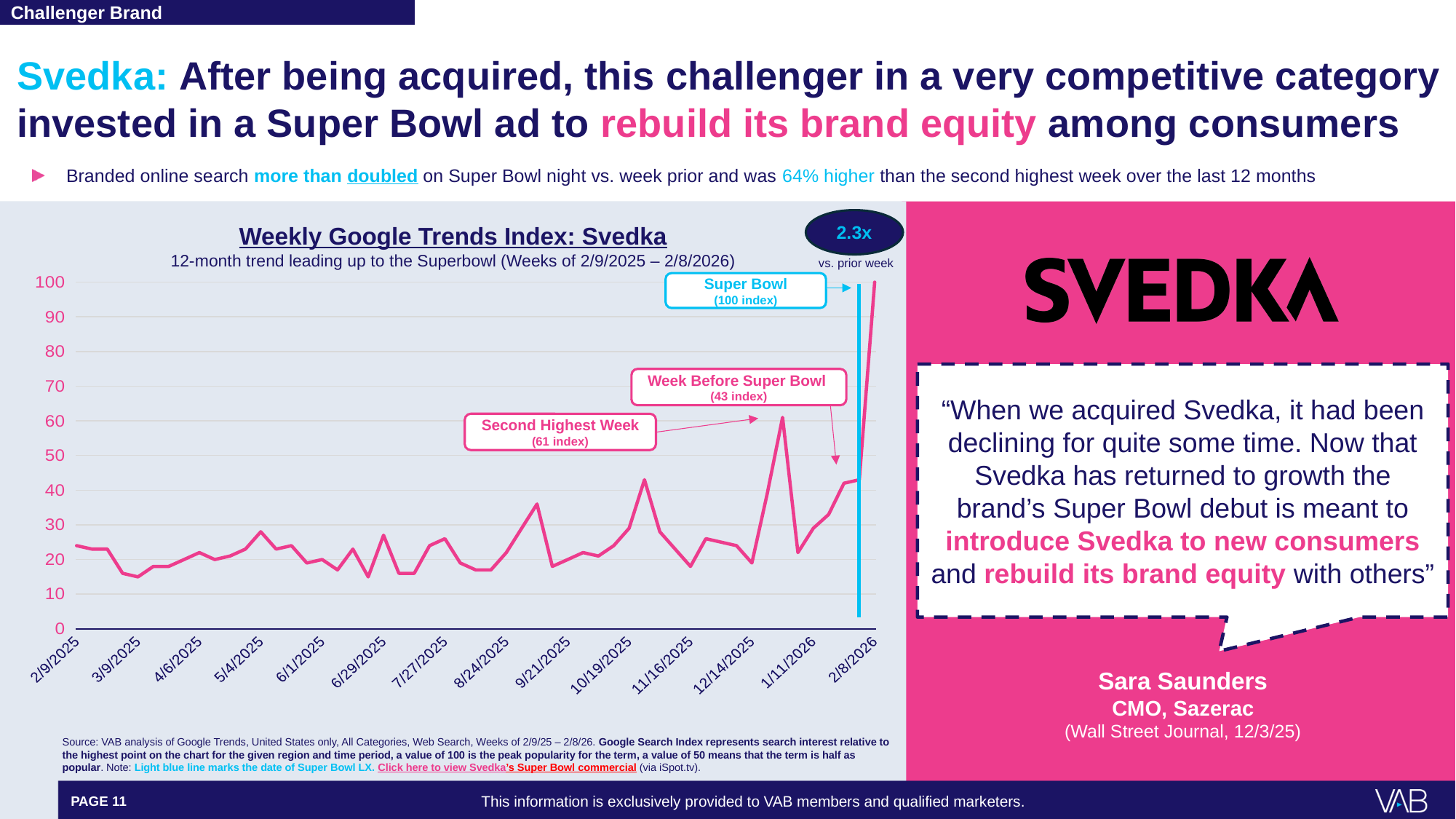
Is the index value for the week of 2/9/2025 greater or less than 30? less What is the difference between the Super Bowl week index and the week before the Super Bowl index? 57 What kind of chart is shown on the slide? line chart What is the index value for the second highest week? 61 What is the title of the chart? Weekly Google Trends Index: Svedka How many date labels are shown on the x axis? 14 What does the light blue vertical line on the chart mark? The date of Super Bowl LX What is the difference between the Super Bowl week index and the second highest week index? 39 Which week has the highest index value on the chart? Super Bowl week (2/8/2026) What is the index value for the week before the Super Bowl? 43 Which is larger, the Super Bowl week index or the second highest week index? Super Bowl week What is the index value for the Super Bowl week? 100